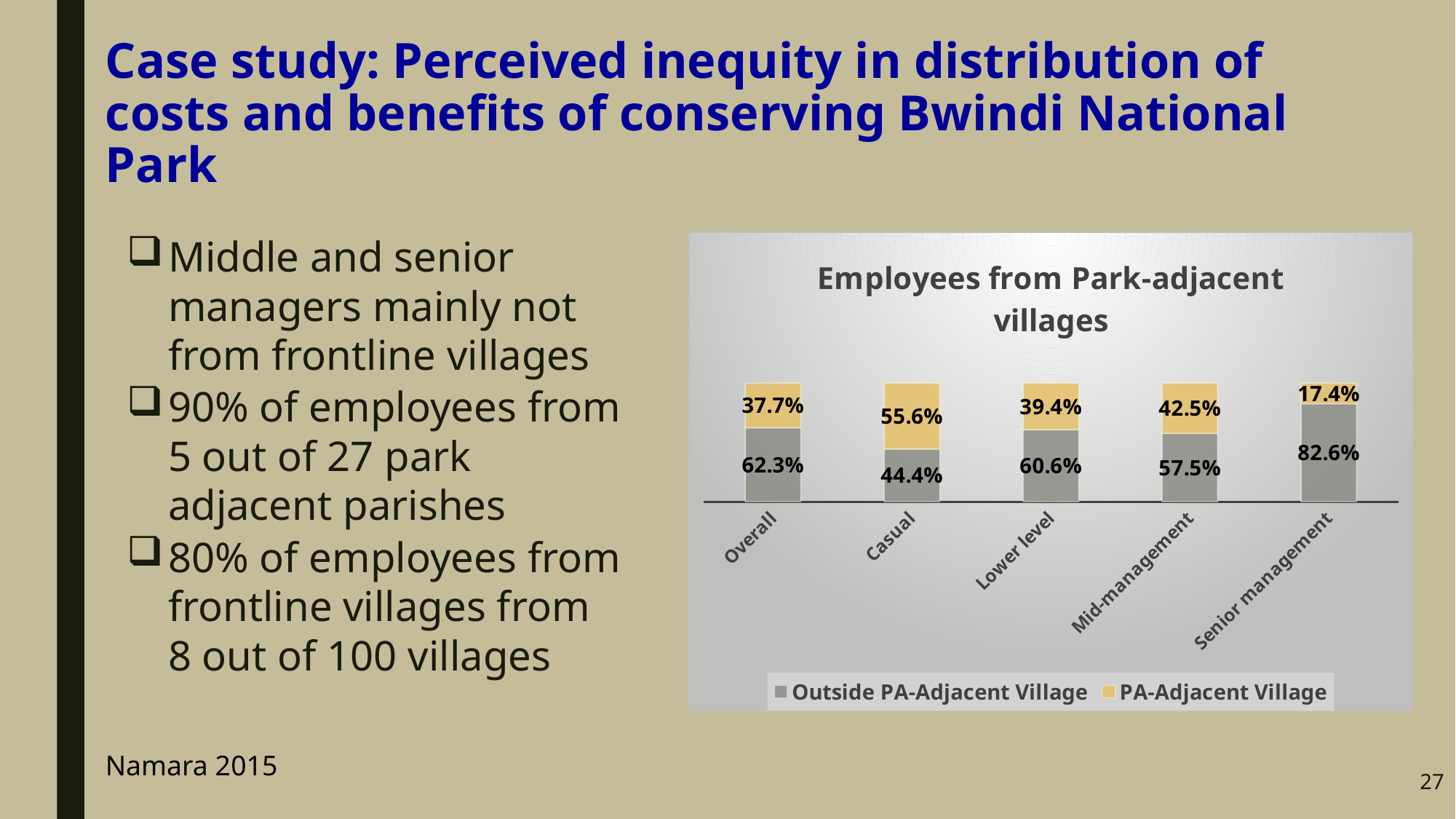
How many categories are shown on the x axis? 5 What is the value for PA-Adjacent Village in the Casual category? 55.6% Which category has the lowest value for PA-Adjacent Village? Senior management What kind of chart is shown? Stacked bar chart What is the difference between the Outside PA-Adjacent Village and PA-Adjacent Village values in the Lower level category? 21.2% What is the value for PA-Adjacent Village in the Mid-management category? 42.5% How many series does the legend list? 2 Which category has the highest value for PA-Adjacent Village? Casual Which is larger in the Casual category: Outside PA-Adjacent Village or PA-Adjacent Village? PA-Adjacent Village What is the value for Outside PA-Adjacent Village in the Overall category? 62.3% What is the title of the chart? Employees from Park-adjacent villages What is the value for Outside PA-Adjacent Village in the Senior management category? 82.6%